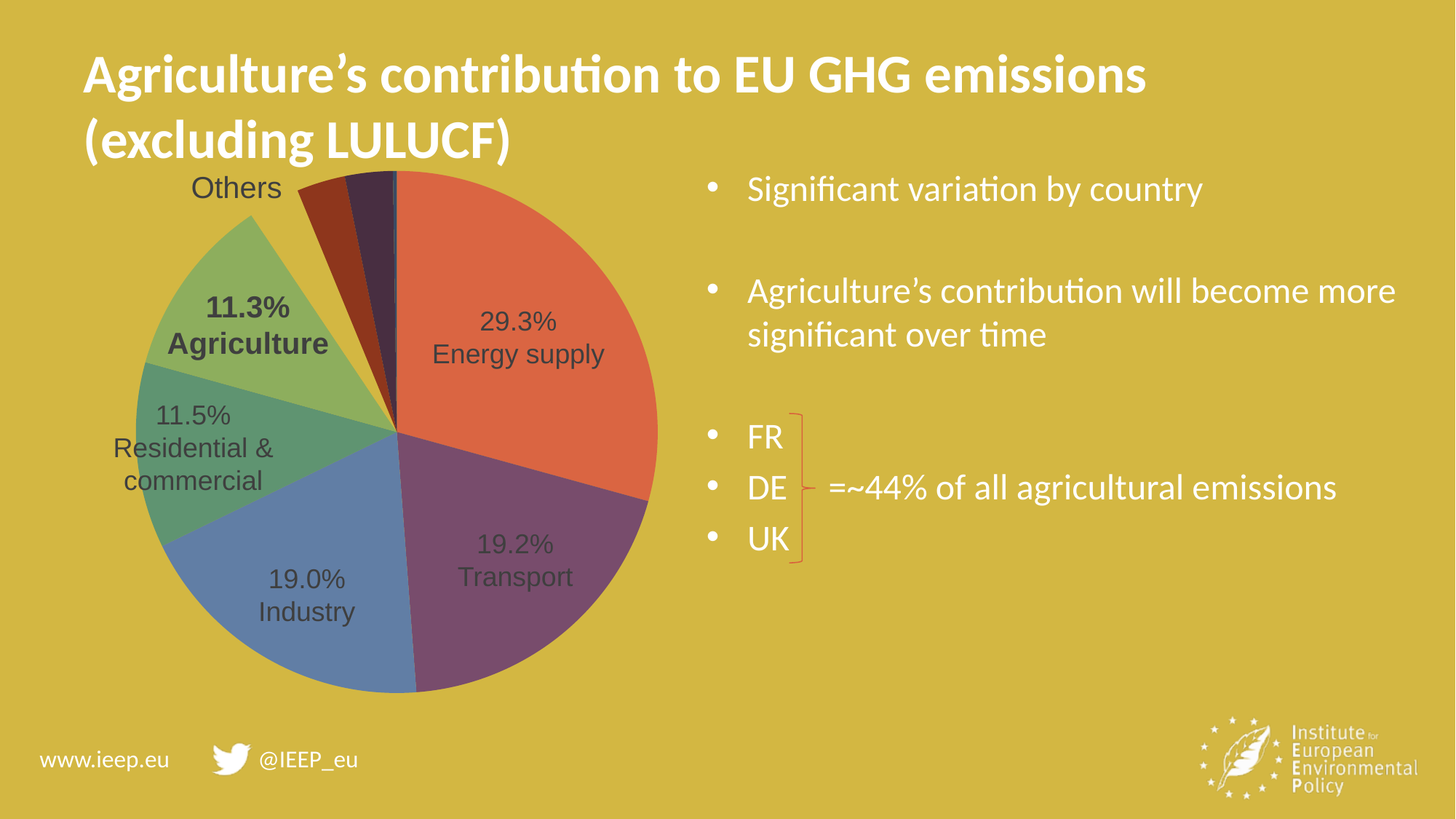
What percentage is shown for Agriculture in the pie chart? 11.3% What is the title of the slide containing the pie chart? Agriculture's contribution to EU GHG emissions (excluding LULUCF) What is the difference in percentage points between the Energy supply share and the Agriculture share? 18.0 What is the combined share of Energy supply, Transport and Industry? 67.5% Which has the larger share, Agriculture or Residential & commercial? Residential & commercial What share of EU GHG emissions does Energy supply account for in the pie chart? 29.3% What percentage is shown for Industry in the pie chart? 19.0% What percentage is shown for Residential & commercial in the pie chart? 11.5% What type of chart is shown on the slide? pie chart Which sector has the largest slice in the pie chart? Energy supply What percentage is shown for Transport in the pie chart? 19.2% Which has the larger share, Transport or Industry? Transport